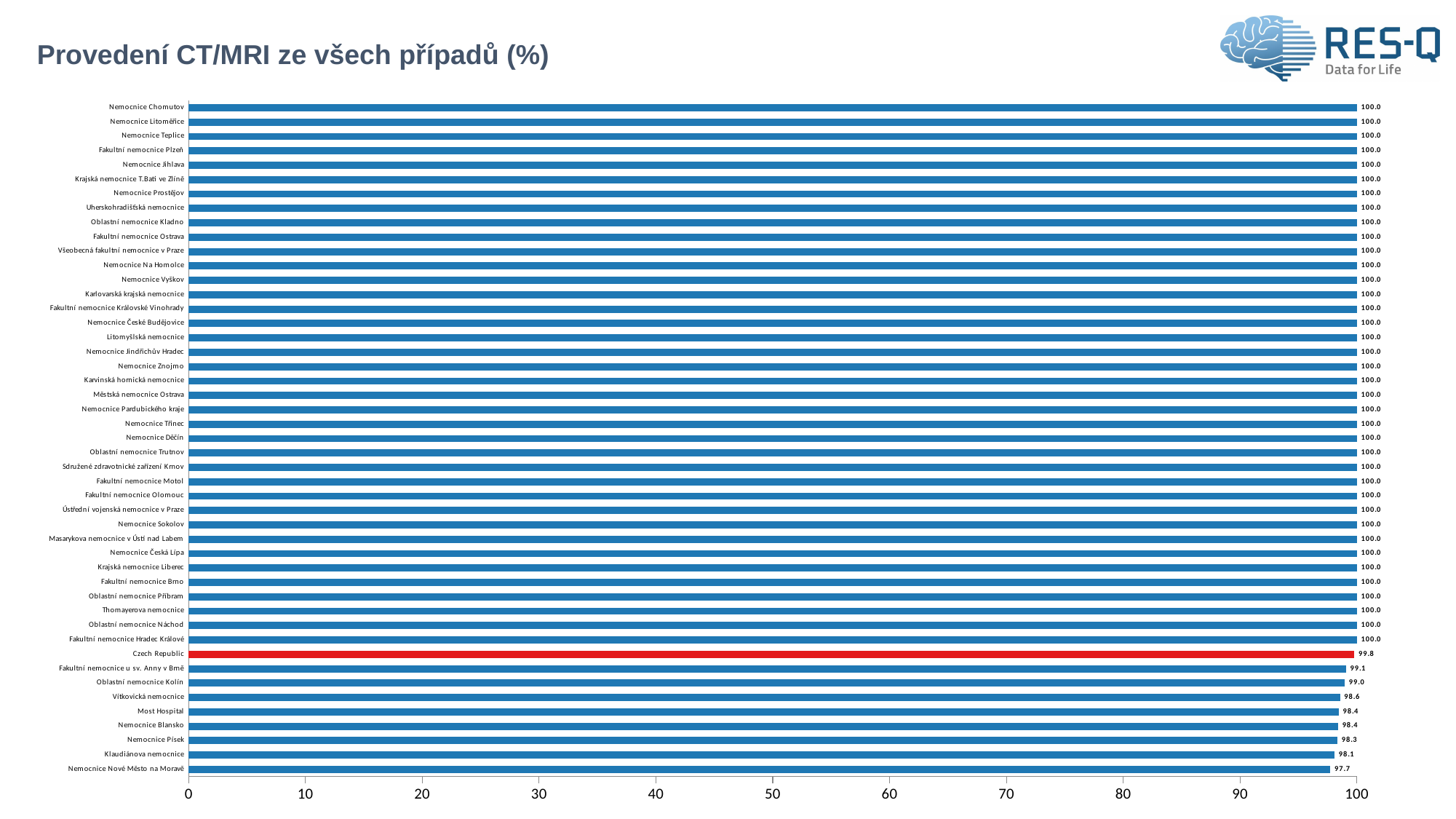
What is the value for Oblastní nemocnice Kolín? 99.0 Is the value for Most Hospital greater or less than 90? greater What kind of chart is shown on the slide? bar chart What is the title of the chart? Provedení CT/MRI ze všech případů (%) Which category has the lowest value? Nemocnice Nové Město na Moravě What is the value for Vítkovická nemocnice? 98.6 What is the value for Nemocnice Nové Město na Moravě? 97.7 What is the difference between the values for Czech Republic and Nemocnice Nové Město na Moravě? 2.1 What is the value for Fakultní nemocnice u sv. Anny v Brně? 99.1 Which is larger, the value for Nemocnice Písek or the value for Nemocnice Blansko? Nemocnice Blansko What is the value for Czech Republic? 99.8 What is the difference between the values for Nemocnice Chomutov and Klaudiánova nemocnice? 1.9